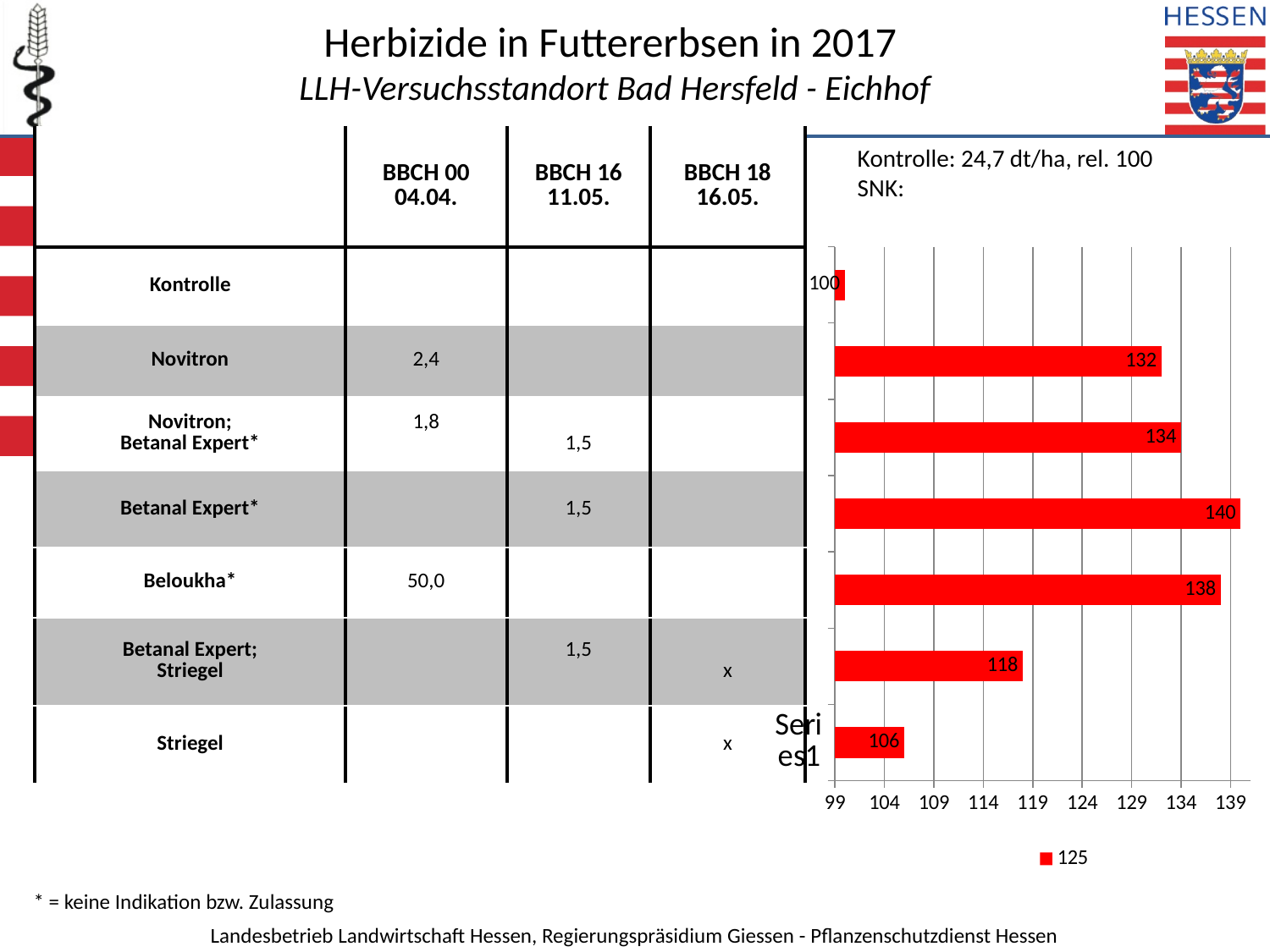
What is the highest value shown in the chart? 140 What text is shown in the chart legend? 125 What is the value of the bar aligned with the Kontrolle row? 100 How many bars are plotted in the chart? 7 What is the difference between the bar aligned with Betanal Expert* (140) and the bar aligned with Betanal Expert; Striegel (118)? 22 What is the value of the bar aligned with the Novitron row? 132 What is the value of the bar aligned with the Beloukha* row? 138 What is the value of the bar aligned with the Striegel row? 106 What is the value of the bar aligned with the Betanal Expert* row? 140 What type of chart is shown on the slide? bar chart Which is larger: the bar aligned with Novitron; Betanal Expert* or the bar aligned with Striegel? Novitron; Betanal Expert* What is the lowest value shown in the chart? 100